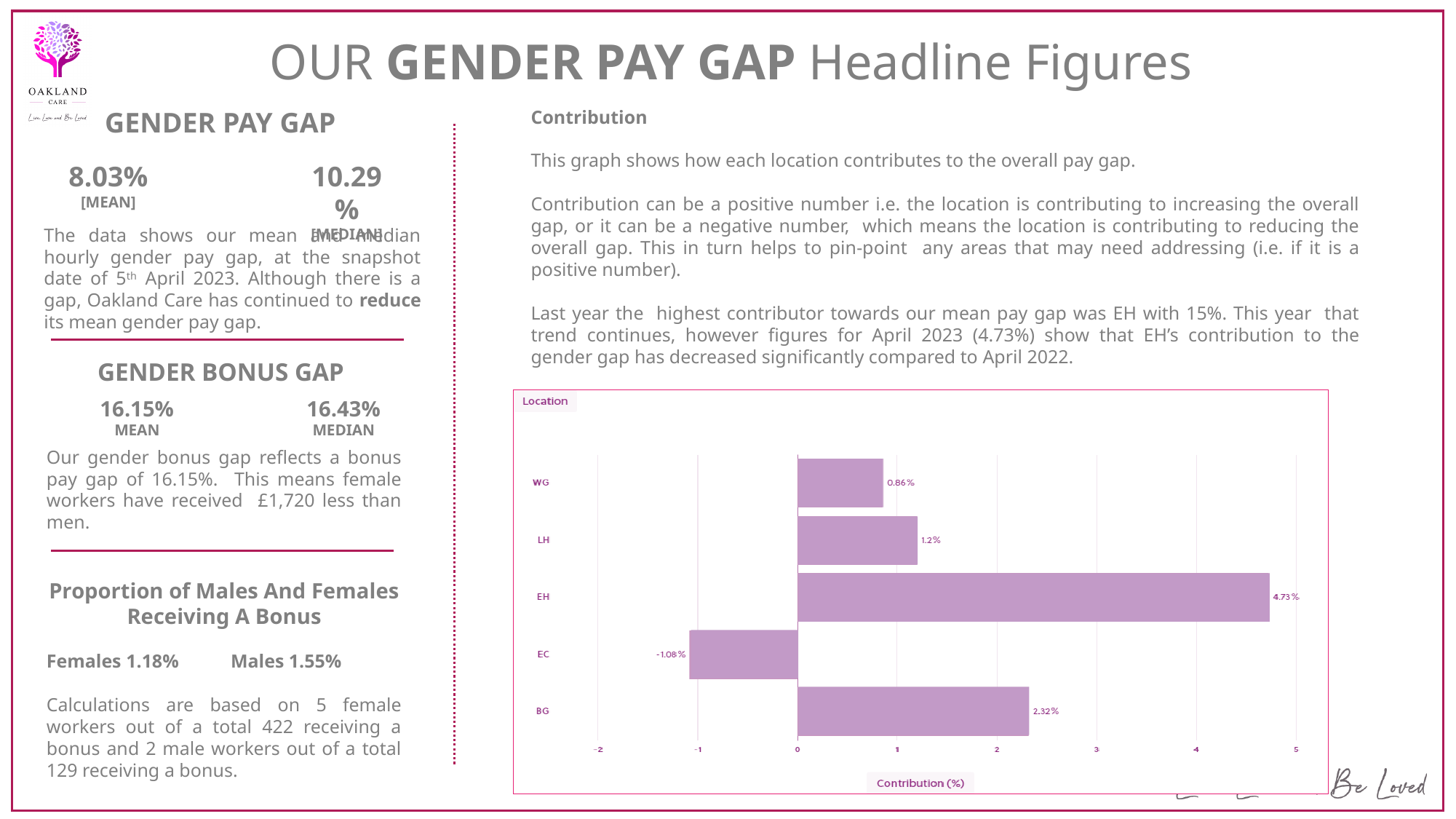
What is the contribution value for EH? 4.73% Is the contribution value for BG greater or less than 2? greater Which location has the highest contribution to the pay gap? EH What is the difference between the contribution of EH and the contribution of BG? 2.41% How many locations are shown in the chart? 5 Which has a larger contribution, LH or WG? LH What is the contribution value for BG? 2.32% What is the contribution value for WG? 0.86% Which location has the lowest contribution to the pay gap? EC What is the label of the horizontal axis of the chart? Contribution (%) What is the contribution value for EC? -1.08% What kind of chart is used to show the contribution by location? Bar chart